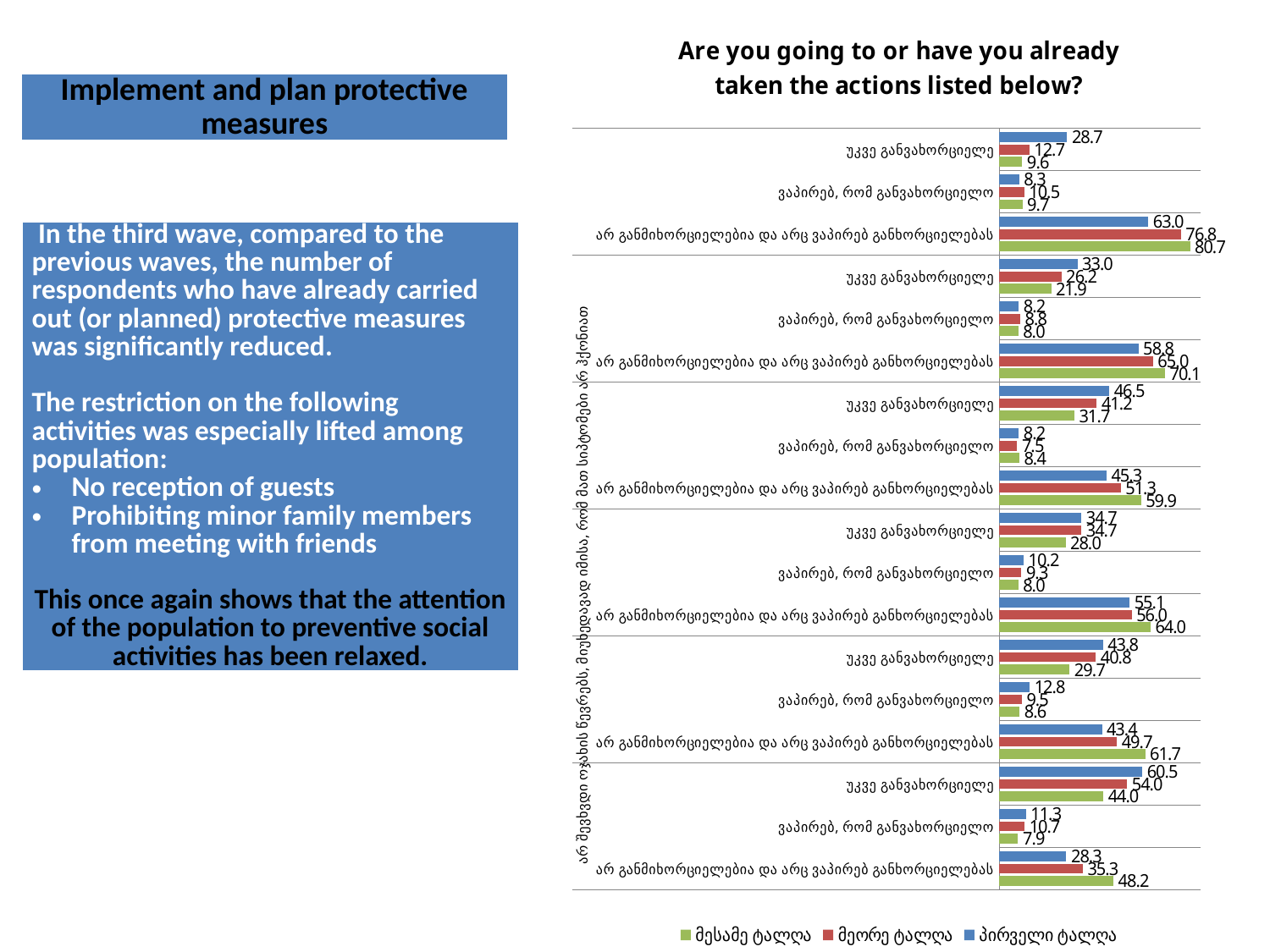
In the bottommost group of bars, which series has the highest value for უკვე განვახორციელე? პირველი ტალღა What is the largest data label value shown anywhere in the chart? 80.7 In the third group of bars from the top, what is the value of the პირველი ტალღა (blue) bar for უკვე განვახორციელე? 46.5 How many series does the chart legend list? 3 In the bottommost group of bars, what is the value of the მეორე ტალღა (red) bar for უკვე განვახორციელე? 54.0 What is the title of the chart? Are you going to or have you already taken the actions listed below? In the topmost group of bars, what is the value of the პირველი ტალღა (blue) bar for უკვე განვახორციელე? 28.7 In the topmost group of bars, what is the difference between the მესამე ტალღა (green) and პირველი ტალღა (blue) values for არ განმიხორციელებია და არც ვაპირებ განხორციელებას? 17.7 In the bottommost group of bars, which is larger for არ განმიხორციელებია და არც ვაპირებ განხორციელებას: the მესამე ტალღა (green) value or the პირველი ტალღა (blue) value? მესამე ტალღა What kind of chart is shown on the slide? bar chart In the topmost group of bars, what is the value of the მესამე ტალღა (green) bar for არ განმიხორციელებია და არც ვაპირებ განხორციელებას? 80.7 Which colour represents მესამე ტალღა in the chart legend? green